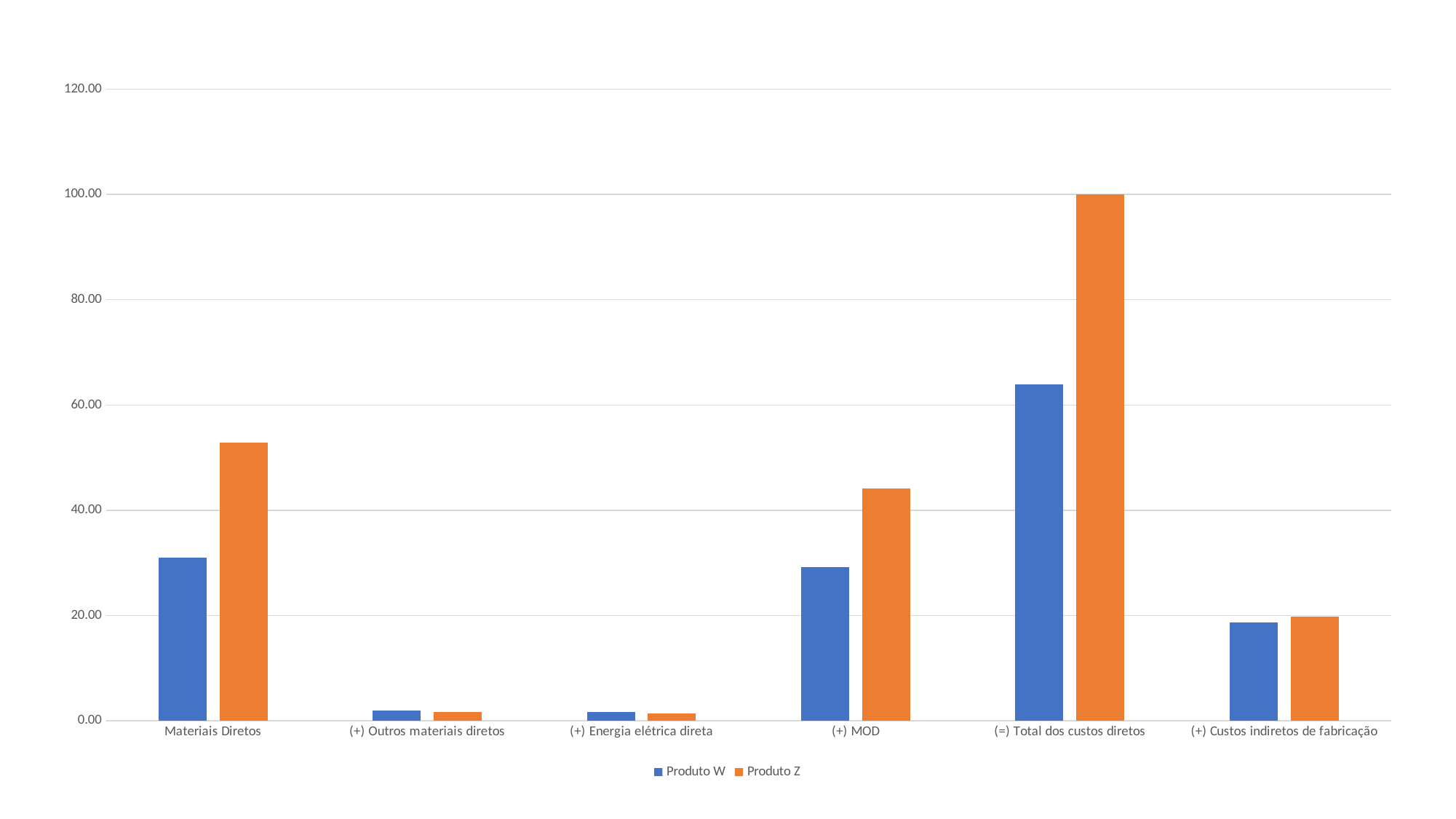
Is the value of Produto W for Materiais Diretos greater or less than 40.00? less For (+) MOD, which series has the larger value, Produto W or Produto Z? Produto Z Which category has the highest value for Produto W? (=) Total dos custos diretos How many series does the legend list? 2 What kind of chart is shown on the slide? bar chart Is the value of Produto Z for Materiais Diretos greater or less than 40.00? greater Which colour represents Produto Z in the legend? orange Is the value of Produto W for (=) Total dos custos diretos greater or less than 60.00? greater How many categories are shown on the x axis? 6 Which category has the highest value for Produto Z? (=) Total dos custos diretos For Materiais Diretos, which series has the larger value, Produto W or Produto Z? Produto Z